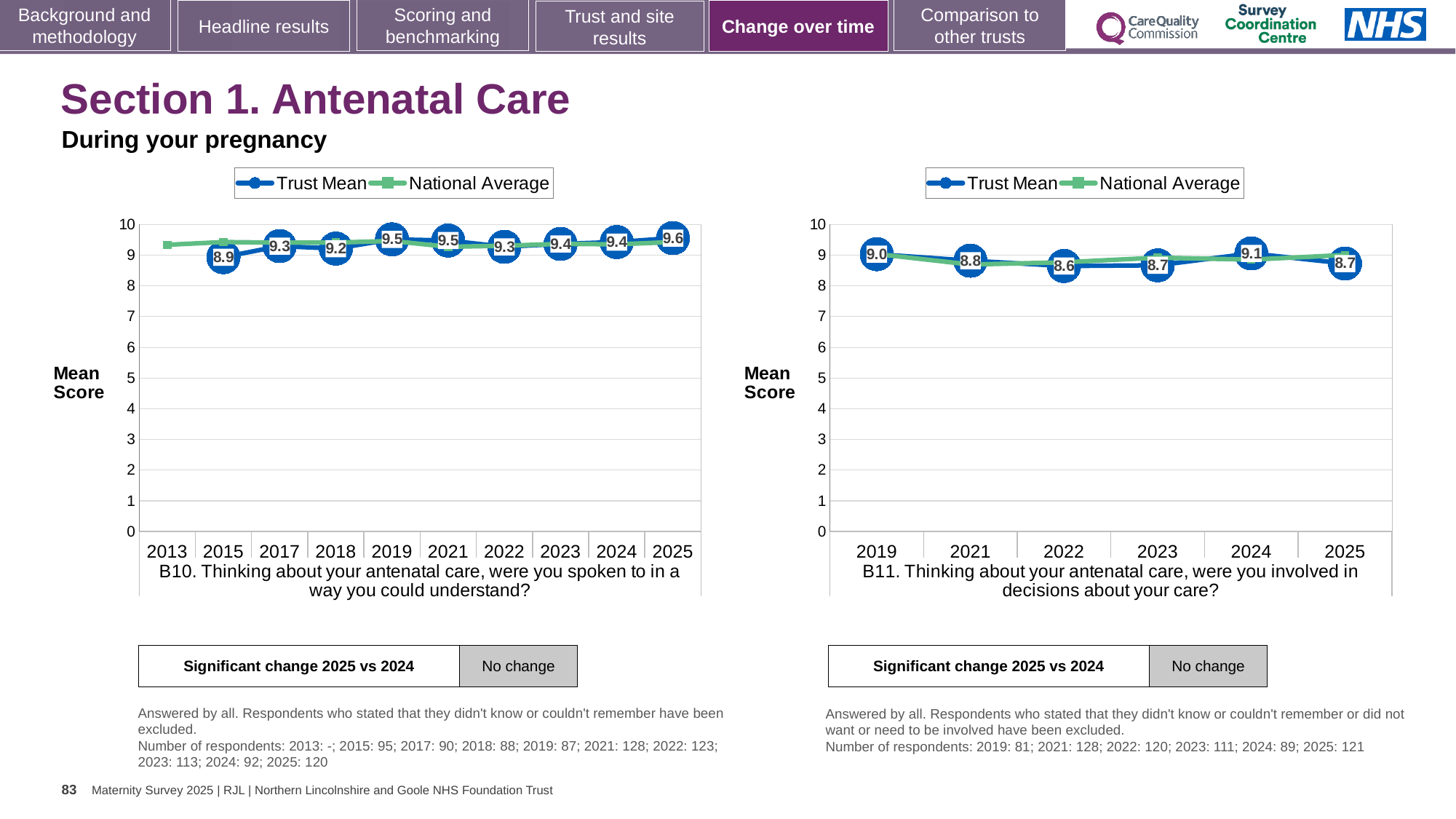
In the left chart (B10), which year has the highest Trust Mean? 2025 In the left chart (B10), what is the Trust Mean for 2015? 8.9 What kind of chart is the left chart (B10)? Line chart In the right chart (B11), what is the Trust Mean for 2024? 9.1 In the left chart (B10), how many years are shown on the x axis? 10 In the left chart (B10), what is the Trust Mean for 2025? 9.6 In the right chart (B11), what is the difference between the Trust Mean in 2024 and in 2022? 0.5 In the right chart (B11), which year has the lowest Trust Mean? 2022 In the left chart (B10), what is the difference between the Trust Mean in 2025 and in 2015? 0.7 In the right chart (B11), is the Trust Mean for 2019 larger or smaller than the Trust Mean for 2021? larger How many series does the legend of the right chart (B11) list? 2 In the left chart (B10), which year has the lowest labelled Trust Mean? 2015